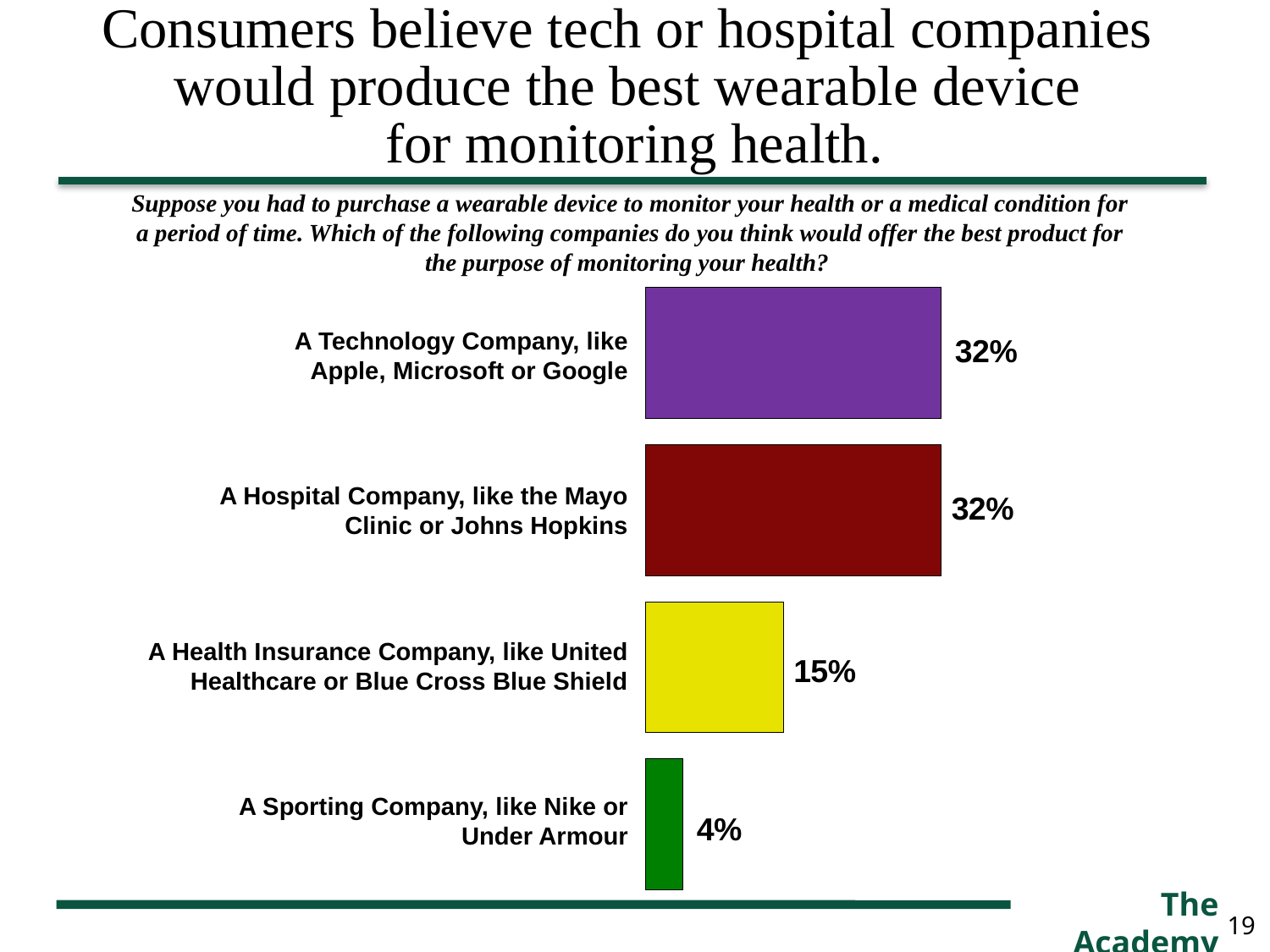
What colour is the bar for the sporting company? Green What percentage of consumers chose a sporting company, like Nike or Under Armour? 4% What percentage of consumers chose a hospital company, like the Mayo Clinic or Johns Hopkins? 32% Which company type received the lowest percentage? A Sporting Company, like Nike or Under Armour Which is larger, the value for the health insurance company or the value for the sporting company? A Health Insurance Company, like United Healthcare or Blue Cross Blue Shield What percentage of consumers chose a technology company, like Apple, Microsoft or Google? 32% What is the difference in percentage points between the health insurance company and the sporting company? 11 What kind of chart is shown on the slide? Bar chart What is the difference in percentage points between the technology company and the health insurance company? 17 How many company types are shown in the chart? 4 What colour is the bar for the hospital company? Dark red What percentage of consumers chose a health insurance company, like United Healthcare or Blue Cross Blue Shield? 15%